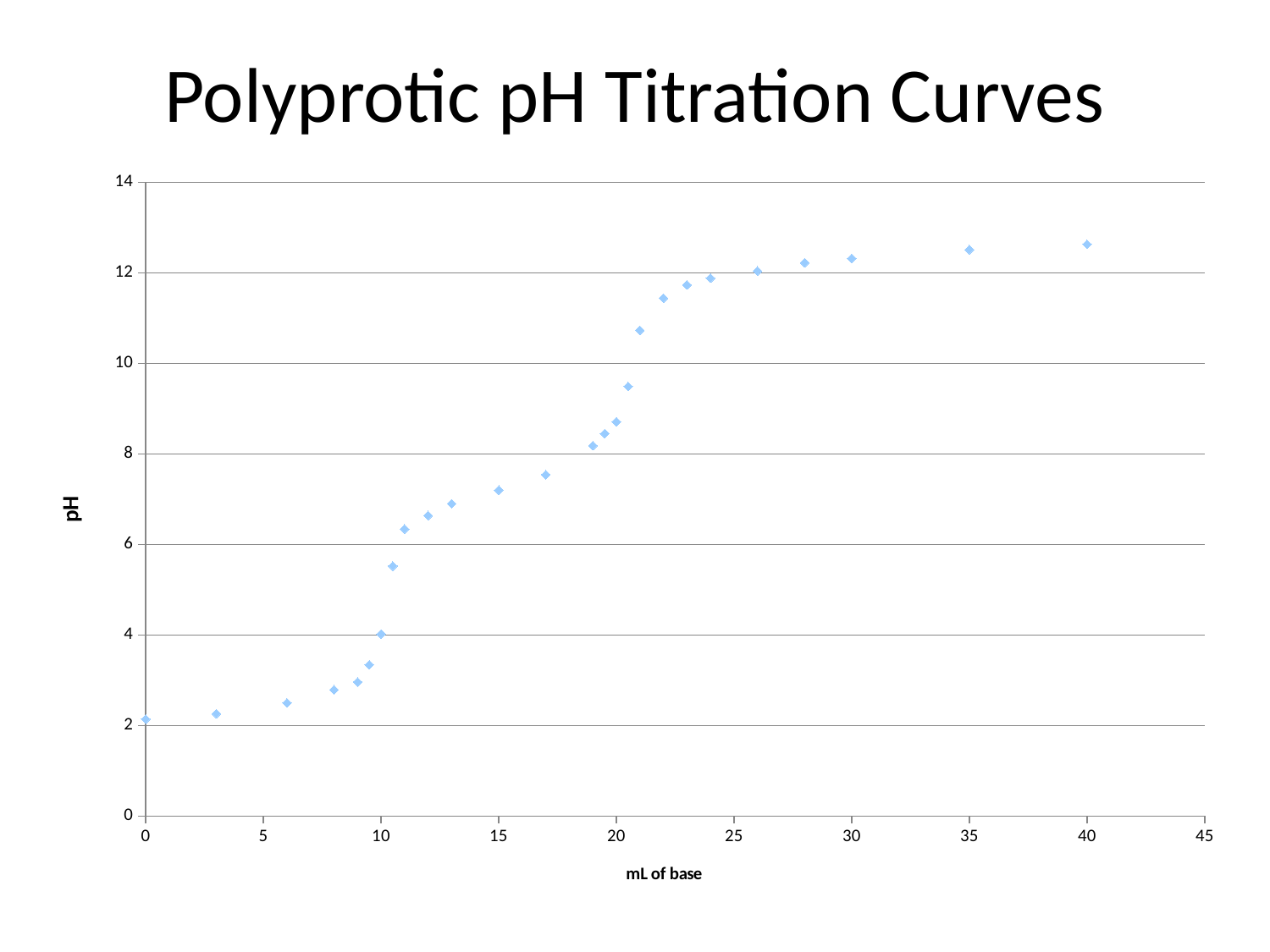
What is the title of the chart? Polyprotic pH Titration Curves Is the pH at 30 mL of base greater or less than 10? greater Is the pH at 0 mL of base greater or less than 4? less Is the pH at 15 mL of base greater or less than 6? greater Which has the higher pH: 10 mL of base or 20 mL of base? 20 mL of base Does the pH rise or fall as mL of base increases along the x axis? rise What is the label on the x axis of the chart? mL of base What kind of chart is shown on the slide? scatter chart Which has the lower pH: 3 mL of base or 13 mL of base? 3 mL of base